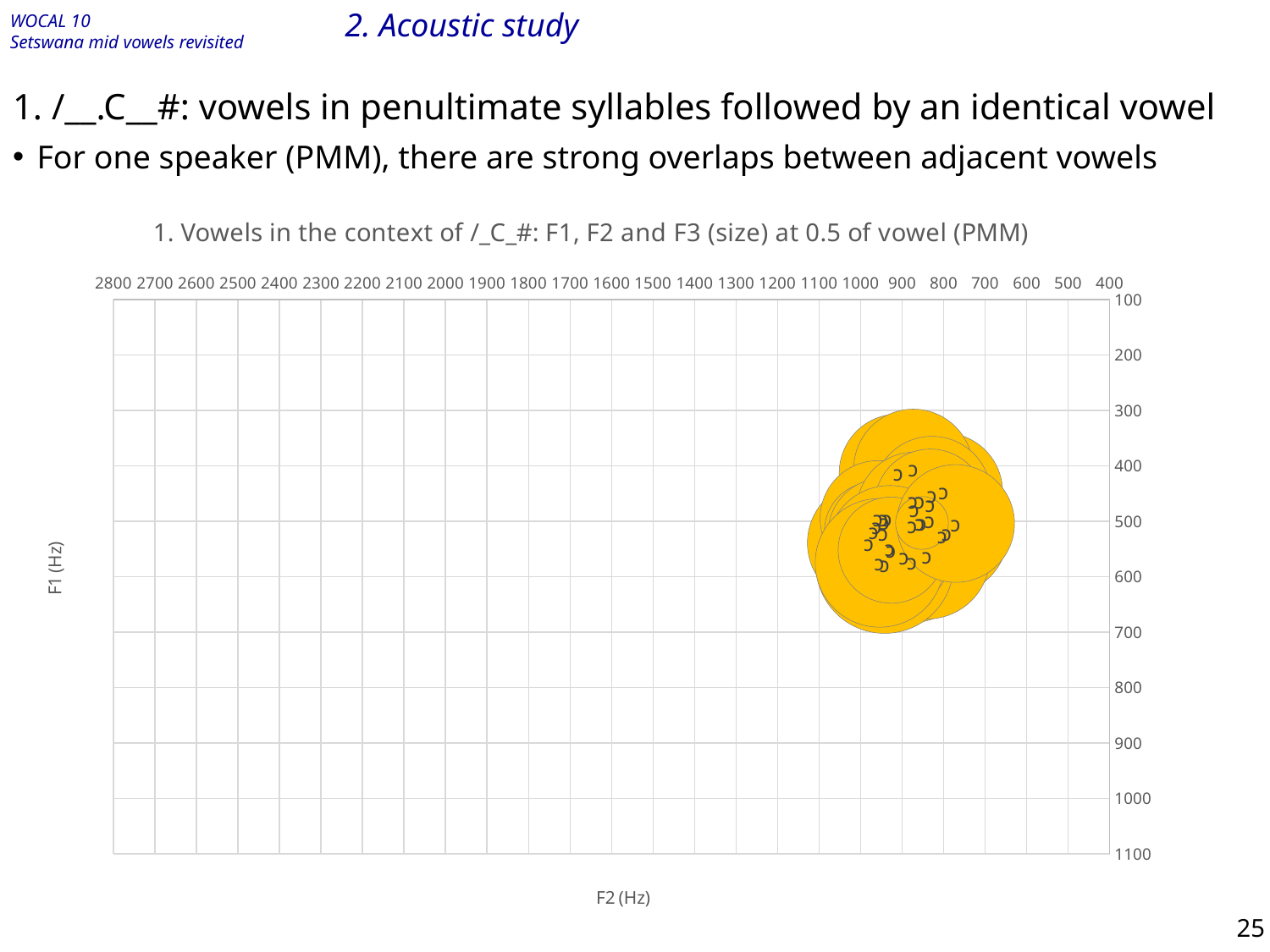
What is the highest value shown on the F1 (Hz) axis? 1100 What kind of chart is shown on the slide? bubble chart Are the F1 values of the plotted vowel bubbles greater or less than 800 Hz? less What is the lowest value shown on the F2 (Hz) axis? 400 Which measurement is represented by the size of the bubbles in the chart? F3 What is the title of the chart? 1. Vowels in the context of /_C_#: F1, F2 and F3 (size) at 0.5 of vowel (PMM) Are the F2 values of the plotted vowel bubbles greater or less than 1500 Hz? less Are the F1 values of the plotted vowel bubbles greater or less than 300 Hz? greater What is the highest value shown on the F2 (Hz) axis? 2800